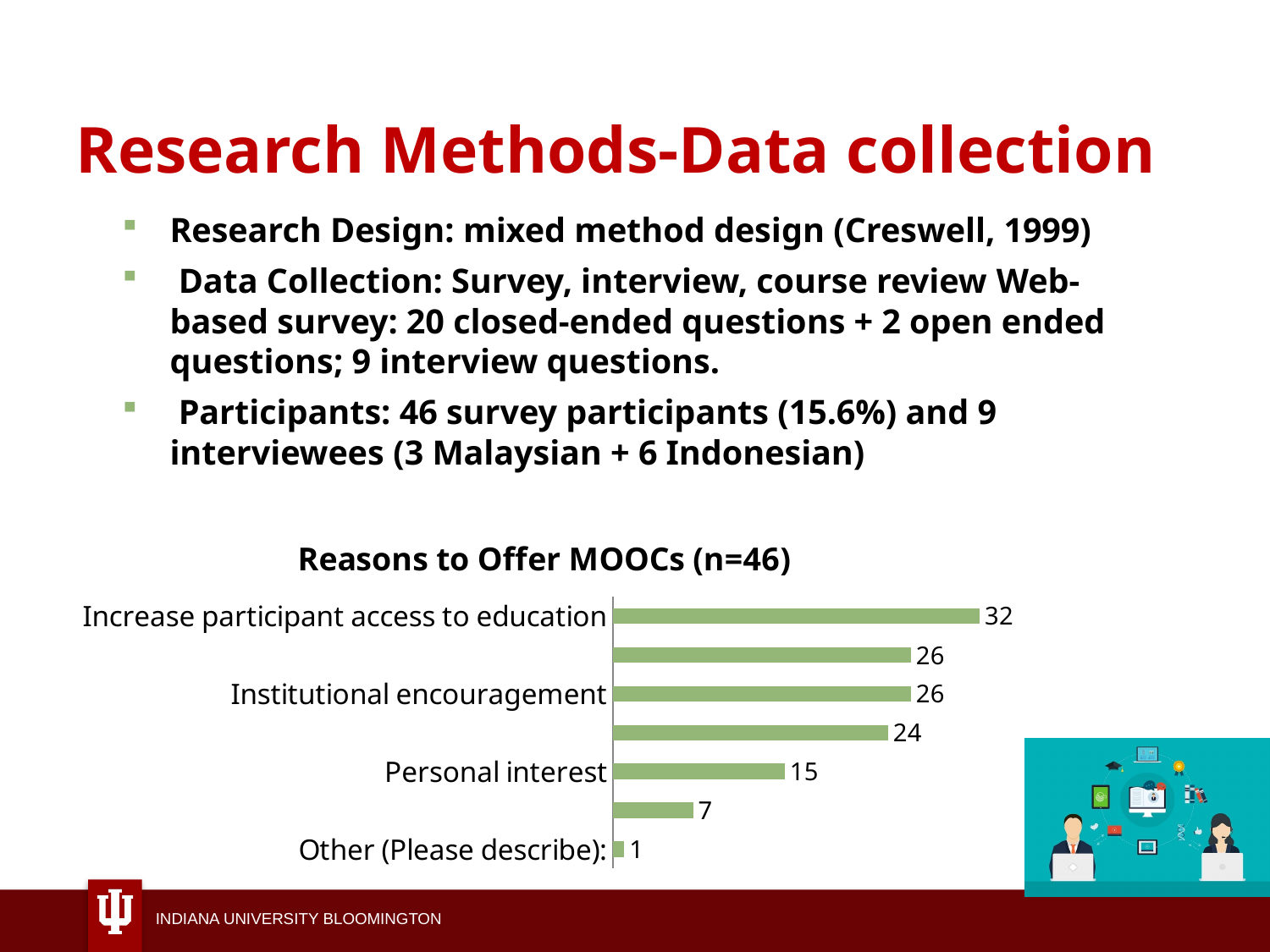
How many bars are plotted in the chart? 7 What is the value for 'Other (Please describe):'? 1 What is the difference between the values for 'Institutional encouragement' and 'Personal interest'? 11 What is the title of the chart? Reasons to Offer MOOCs (n=46) What type of chart is shown on the slide? bar chart What is the value for 'Increase participant access to education'? 32 What is the value for 'Institutional encouragement'? 26 What is the value for 'Personal interest'? 15 Which category has the highest value? Increase participant access to education Which category has the lowest value? Other (Please describe): Which is larger, the value for 'Institutional encouragement' or the value for 'Personal interest'? Institutional encouragement What is the difference between the values for 'Increase participant access to education' and 'Personal interest'? 17